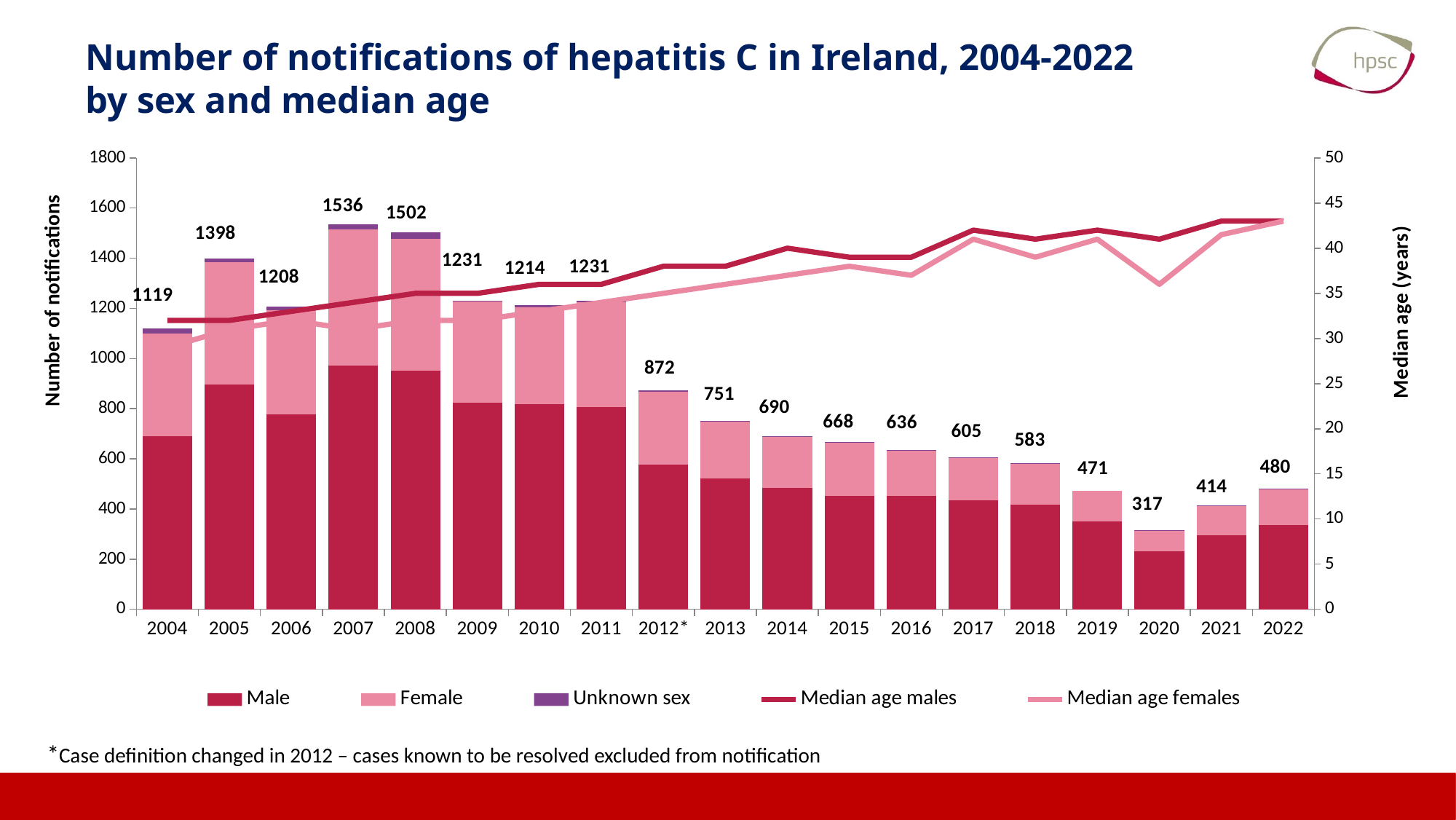
What is the total number of hepatitis C notifications shown for 2007? 1536 How many series does the legend list? 5 Is the number of male notifications in 2004 greater or less than 800? less Which year has the lowest total number of notifications? 2020 What is the difference between the total notifications in 2007 and 2008? 34 What is the total number of notifications labelled for 2012*? 872 What is the total number of notifications labelled for 2020? 317 Which year has the highest total number of notifications? 2007 Do the total notifications rise or fall from 2012* to 2020? fall How many years are shown on the x axis? 19 Which year had more total notifications, 2021 or 2022? 2022 Is the median age of males in 2022 greater or less than 40 years? greater